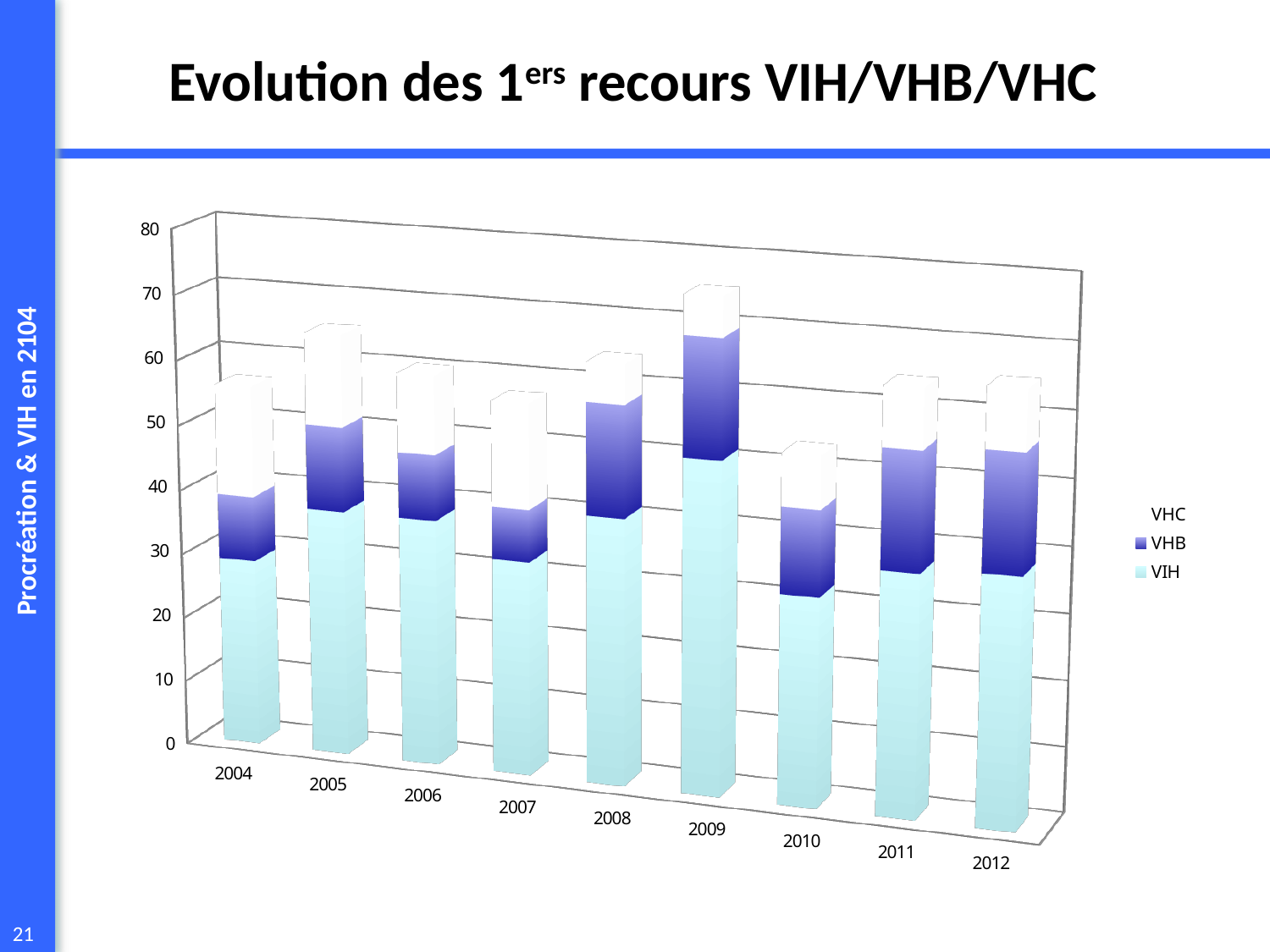
Which series is shown at the bottom of each stacked bar? VIH Which year has the larger total stacked bar, 2009 or 2010? 2009 Is the total stacked value for 2010 greater or less than 60? less Is the VIH value for 2009 greater or less than 40? greater What kind of chart is shown on the slide? bar chart Which year has the shortest stacked bar in the chart? 2010 Is the total stacked value for 2009 greater or less than 60? greater Which year has the tallest stacked bar in the chart? 2009 How many series does the chart legend list? 3 How many years are shown on the x axis of the chart? 9 What are the three series listed in the chart legend? VHC, VHB, VIH